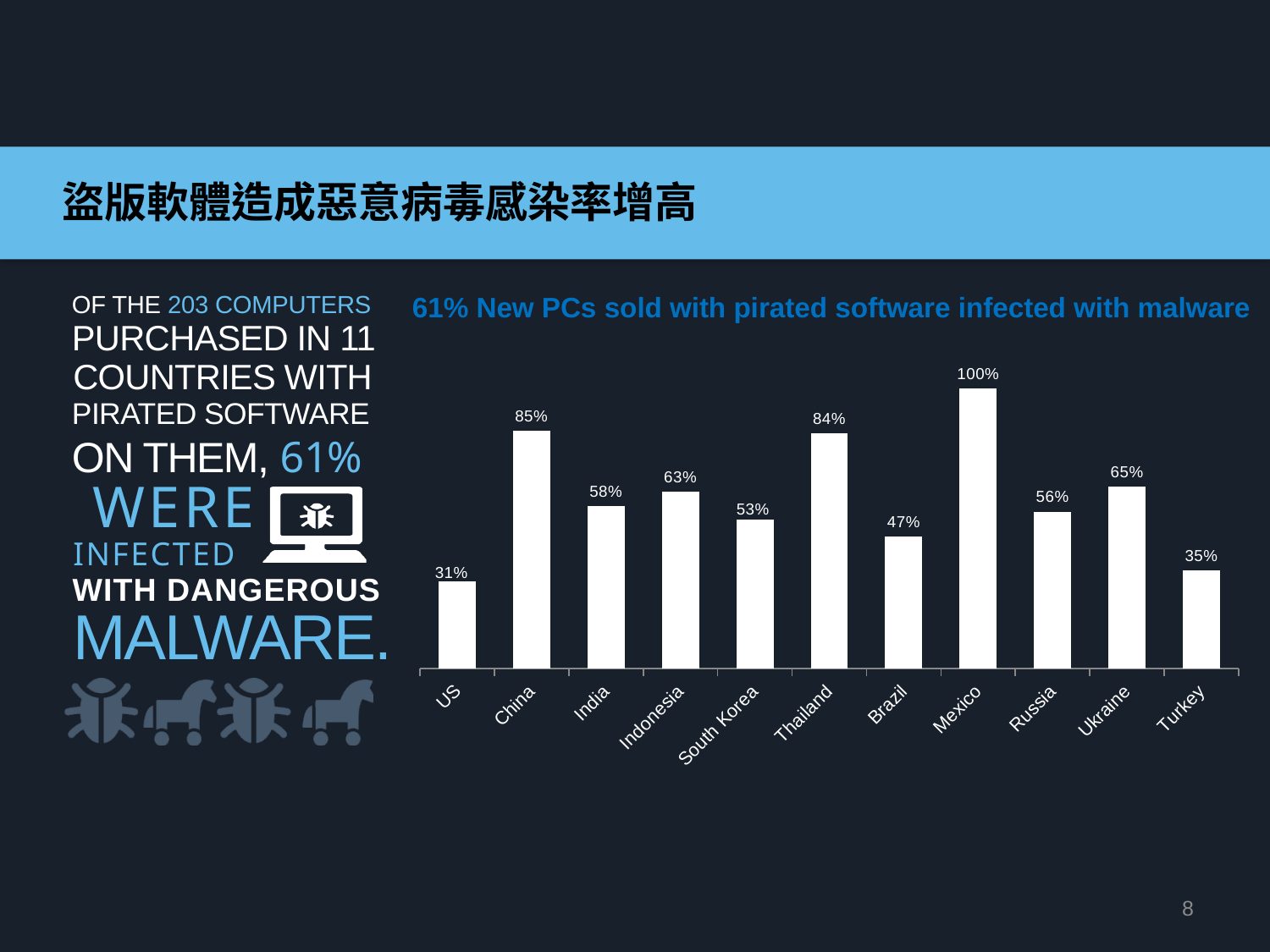
What kind of chart is shown on the slide? Bar chart Which country has the lowest value? US Which country has the highest value? Mexico What is the value for Mexico? 100% What is the difference between the values for Mexico and Turkey? 65% How many countries are shown in the chart? 11 What is the value for Thailand? 84% What is the value for US? 31% Which is larger, the value for Brazil or the value for Russia? Russia What is the value for Ukraine? 65% What is the difference between the values for China and India? 27% What is the title of the chart? 61% New PCs sold with pirated software infected with malware